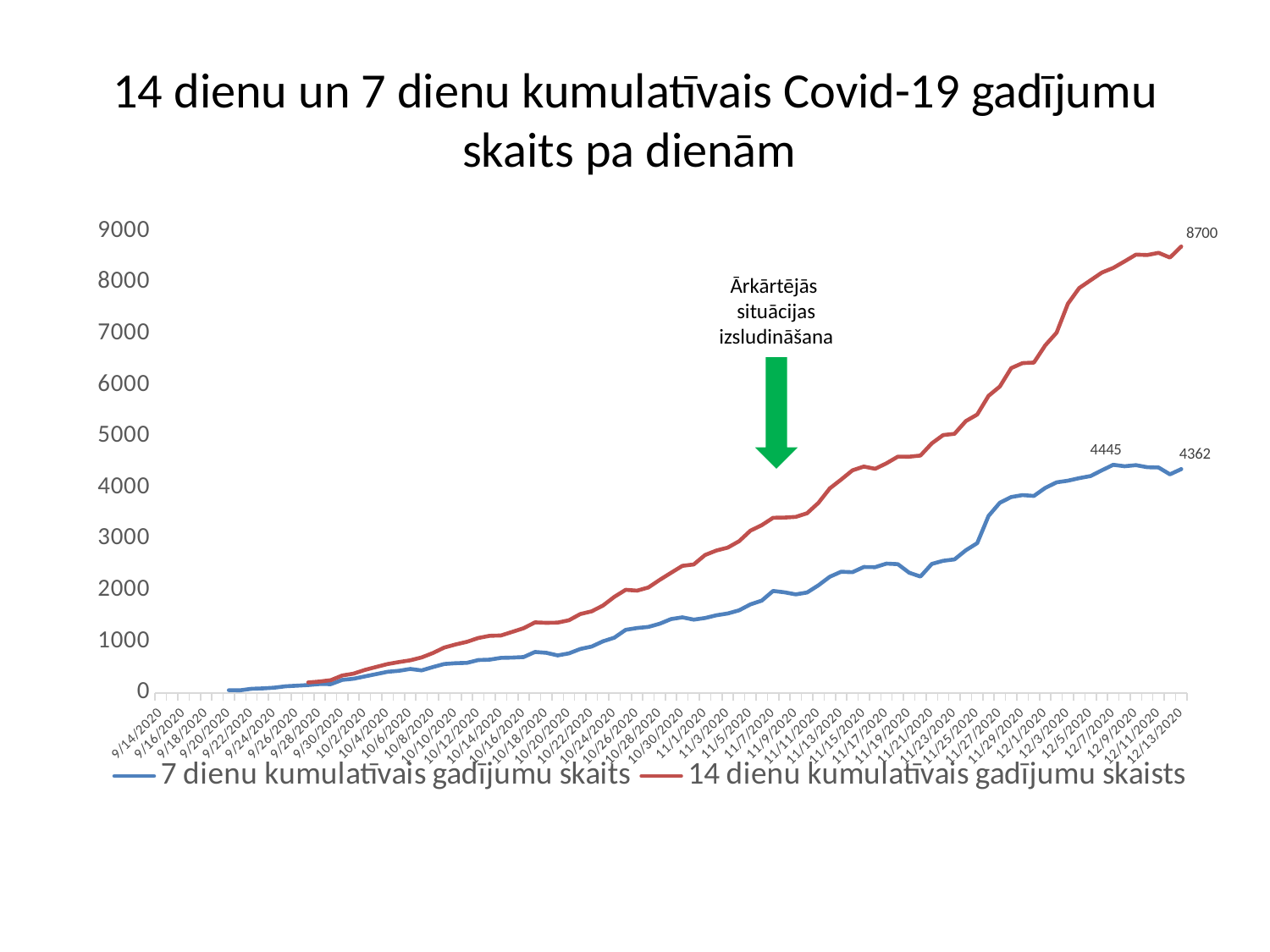
Is the value of the 14 dienu kumulatīvais gadījumu skaits series on 12/1/2020 greater or less than 5000? greater By how much does the labelled peak of the 7-day series (4445) exceed its final value (4362)? 83 What is the final labelled value of the 7 dienu kumulatīvais gadījumu skaits series on 12/13/2020? 4362 How many series does the legend list? 2 What event does the green arrow annotation on the chart mark? Ārkārtējās situācijas izsludināšana What kind of chart is shown on the slide? line chart What is the final labelled value of the 14 dienu kumulatīvais gadījumu skaits series? 8700 Which series reaches the higher value at the end of the chart, the 7-day or the 14-day cumulative count? 14 dienu kumulatīvais gadījumu skaits Is the value of the 7 dienu kumulatīvais gadījumu skaits series on 11/1/2020 greater or less than 2000? less What is the difference between the final labelled values of the 14-day series (8700) and the 7-day series (4362)? 4338 Do the values of the 14-day cumulative series generally rise or fall from 9/14/2020 to 12/13/2020? rise What is the labelled peak value of the 7 dienu kumulatīvais gadījumu skaits series before its final point? 4445